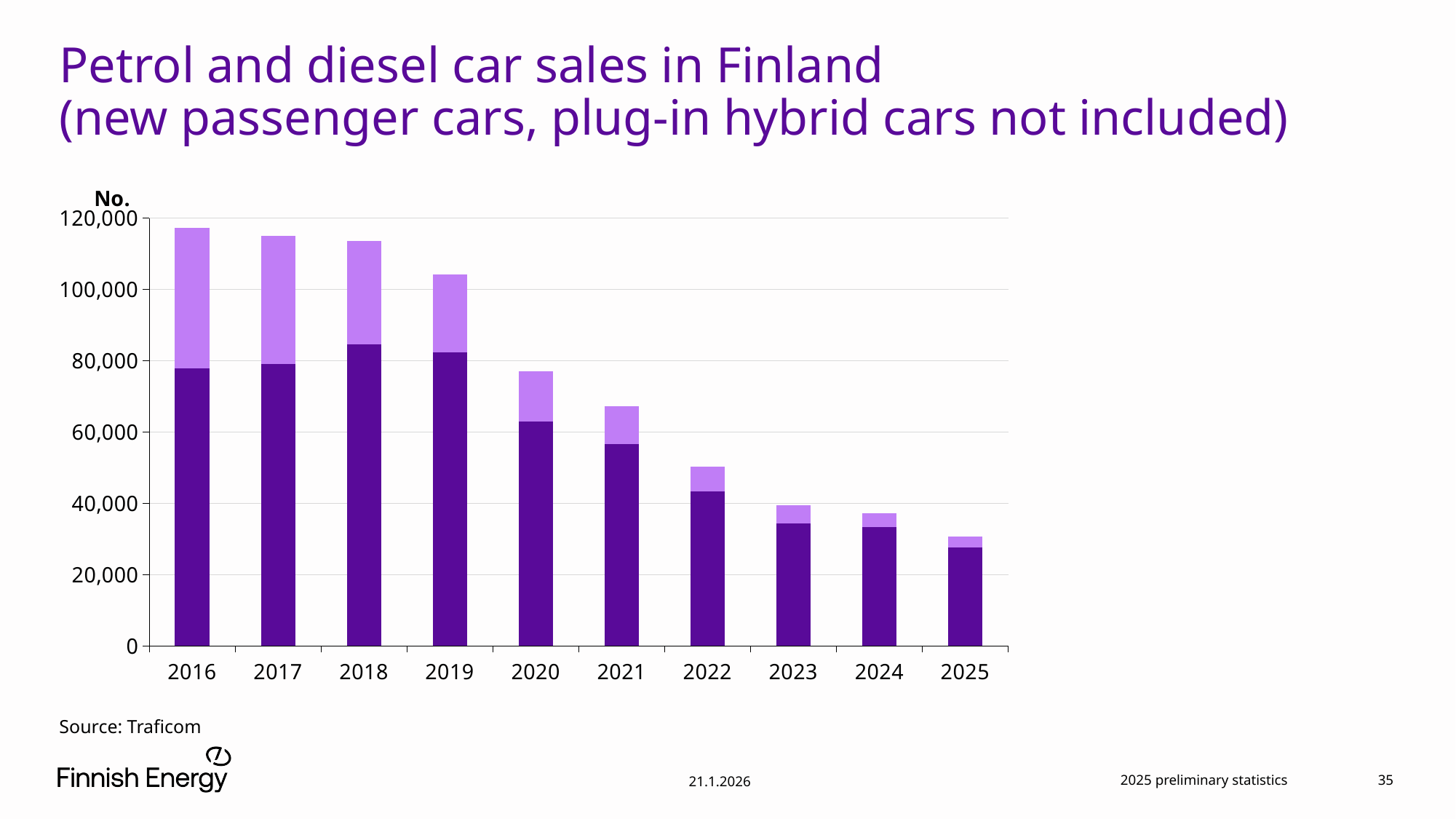
How many years are shown on the x axis of the chart? 10 Which year has the lowest total bar in the chart? 2025 Which year has a larger total bar, 2019 or 2020? 2019 What kind of chart is shown on the slide? Stacked bar chart Is the total value for 2025 greater or less than 40,000? less What is the label on the vertical axis of the chart? No. Is the total value for 2021 greater or less than 60,000? greater Is the total value for 2020 greater or less than 80,000? less What source is cited below the chart? Traficom Which year has the highest total bar in the chart? 2016 Do the total bar heights rise or fall from 2016 to 2025? Fall